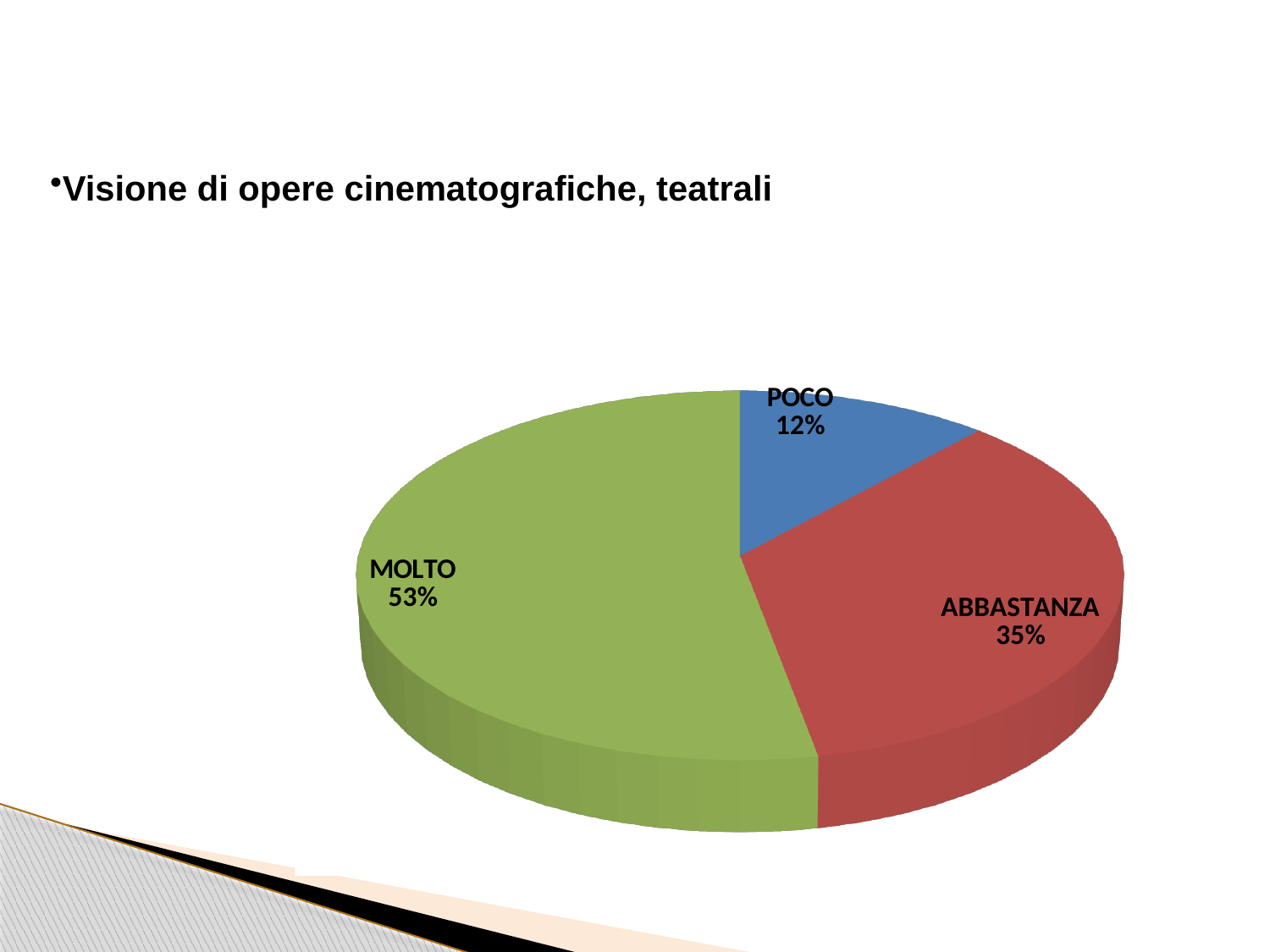
What is the difference in percentage points between the MOLTO and ABBASTANZA slices? 18 What kind of chart is shown on the slide? pie chart Which slice of the pie is the smallest? POCO What is the difference in percentage points between the ABBASTANZA and POCO slices? 23 What colour is the MOLTO slice? green How many slices does the pie chart have? 3 Which slice of the pie is the largest? MOLTO Which slice is larger, ABBASTANZA or POCO? ABBASTANZA What percentage of the pie is labelled ABBASTANZA? 35% What is the title text shown above the chart? Visione di opere cinematografiche, teatrali What percentage of the pie is labelled POCO? 12% What percentage of the pie is labelled MOLTO? 53%